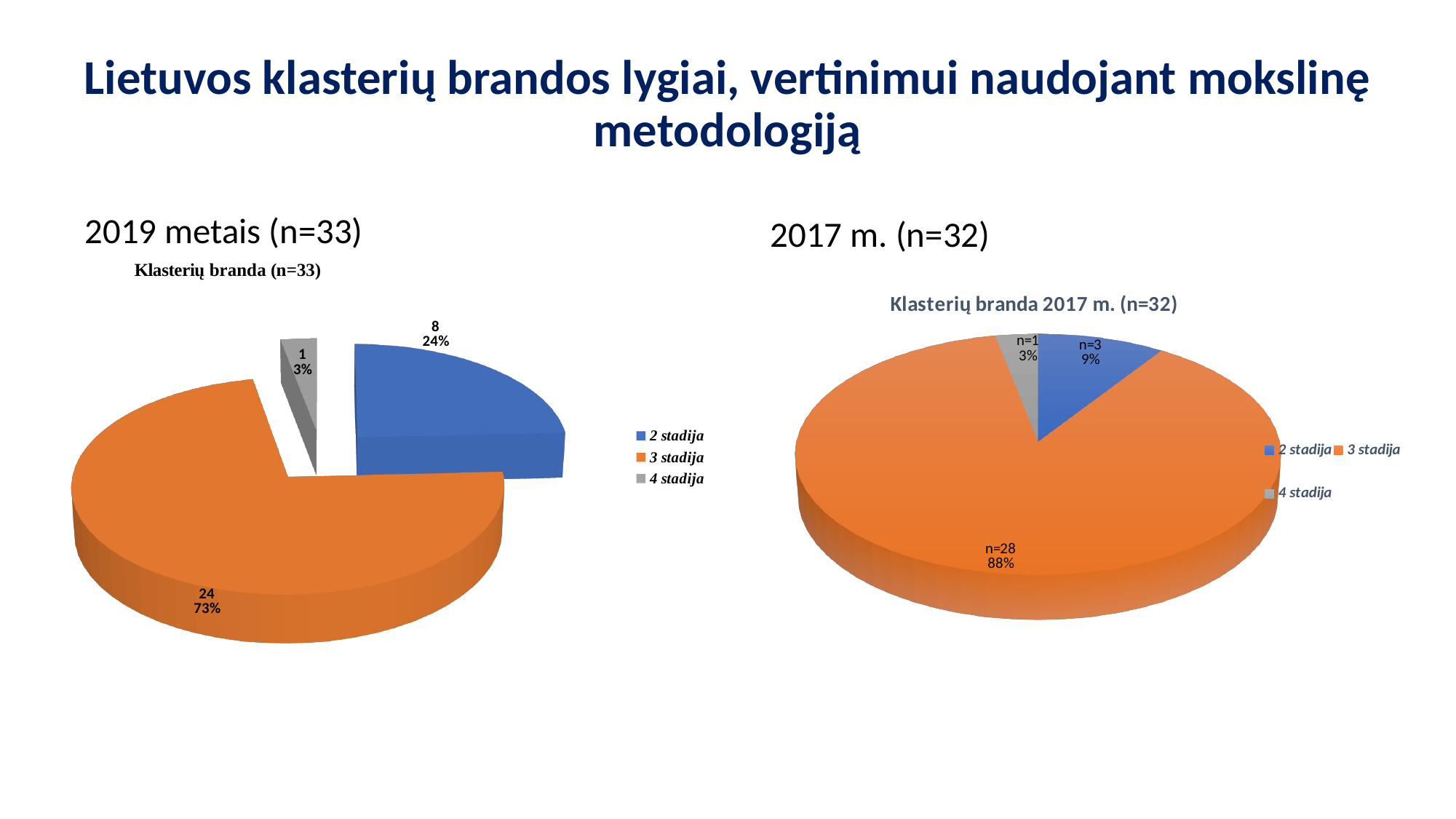
In the right chart (Klasterių branda 2017 m. (n=32)), what share of the pie is 2 stadija? 9% In the left chart (Klasterių branda (n=33)), what is the difference between the number of clusters in 3 stadija and 2 stadija? 16 In the right chart (Klasterių branda 2017 m. (n=32)), which is larger, the 2 stadija slice or the 4 stadija slice? 2 stadija In the left chart (Klasterių branda (n=33)), what share of the pie is 2 stadija? 24% In the right chart (Klasterių branda 2017 m. (n=32)), how many clusters are in 3 stadija? 28 In the left chart (Klasterių branda (n=33)), what kind of chart is shown? pie chart In the right chart (Klasterių branda 2017 m. (n=32)), which stage has the largest slice? 3 stadija In the left chart (Klasterių branda (n=33)), how many clusters are in 3 stadija? 24 In the left chart (Klasterių branda (n=33)), what colour is the 3 stadija slice? orange In the left chart (Klasterių branda (n=33)), which stage has the smallest slice? 4 stadija In the left chart (Klasterių branda (n=33)), how many slices does the pie have? 3 In the right chart (Klasterių branda 2017 m. (n=32)), how many entries does the legend list? 3